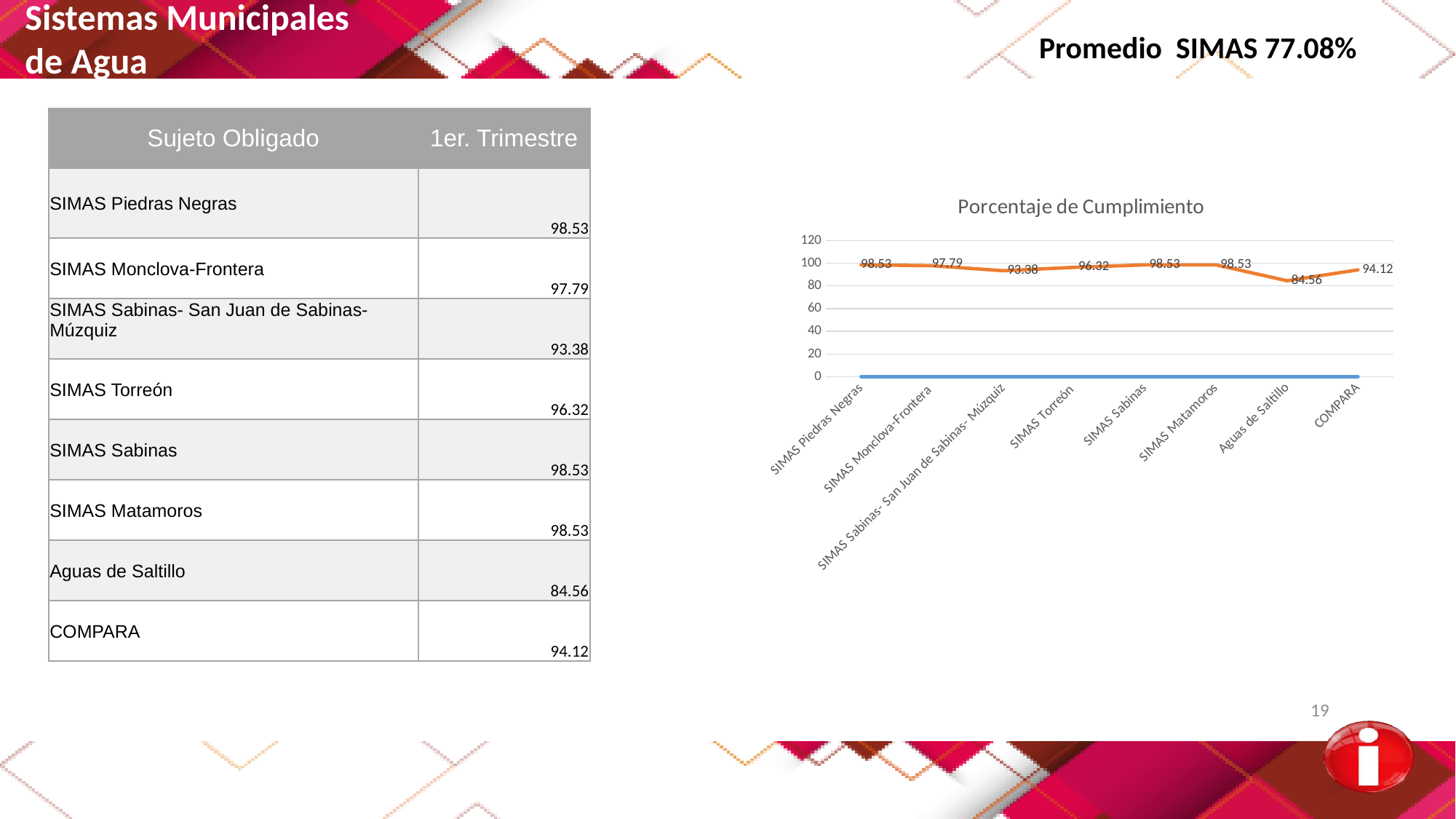
What kind of chart is shown on the slide? line chart What is the value for COMPARA in the chart? 94.12 What is the value for SIMAS Monclova-Frontera in the chart? 97.79 What is the value for Aguas de Saltillo in the chart? 84.56 Which category has the lowest value in the chart? Aguas de Saltillo Is the value for Aguas de Saltillo greater or less than 100? less Which is larger, the value for SIMAS Torreón or the value for SIMAS Sabinas- San Juan de Sabinas- Múzquiz? SIMAS Torreón What is the value for SIMAS Torreón in the chart? 96.32 What is the difference between the values for SIMAS Piedras Negras and Aguas de Saltillo? 13.97 How many categories are plotted along the x axis of the chart? 8 What is the value for SIMAS Piedras Negras in the chart? 98.53 What is the title of the chart? Porcentaje de Cumplimiento